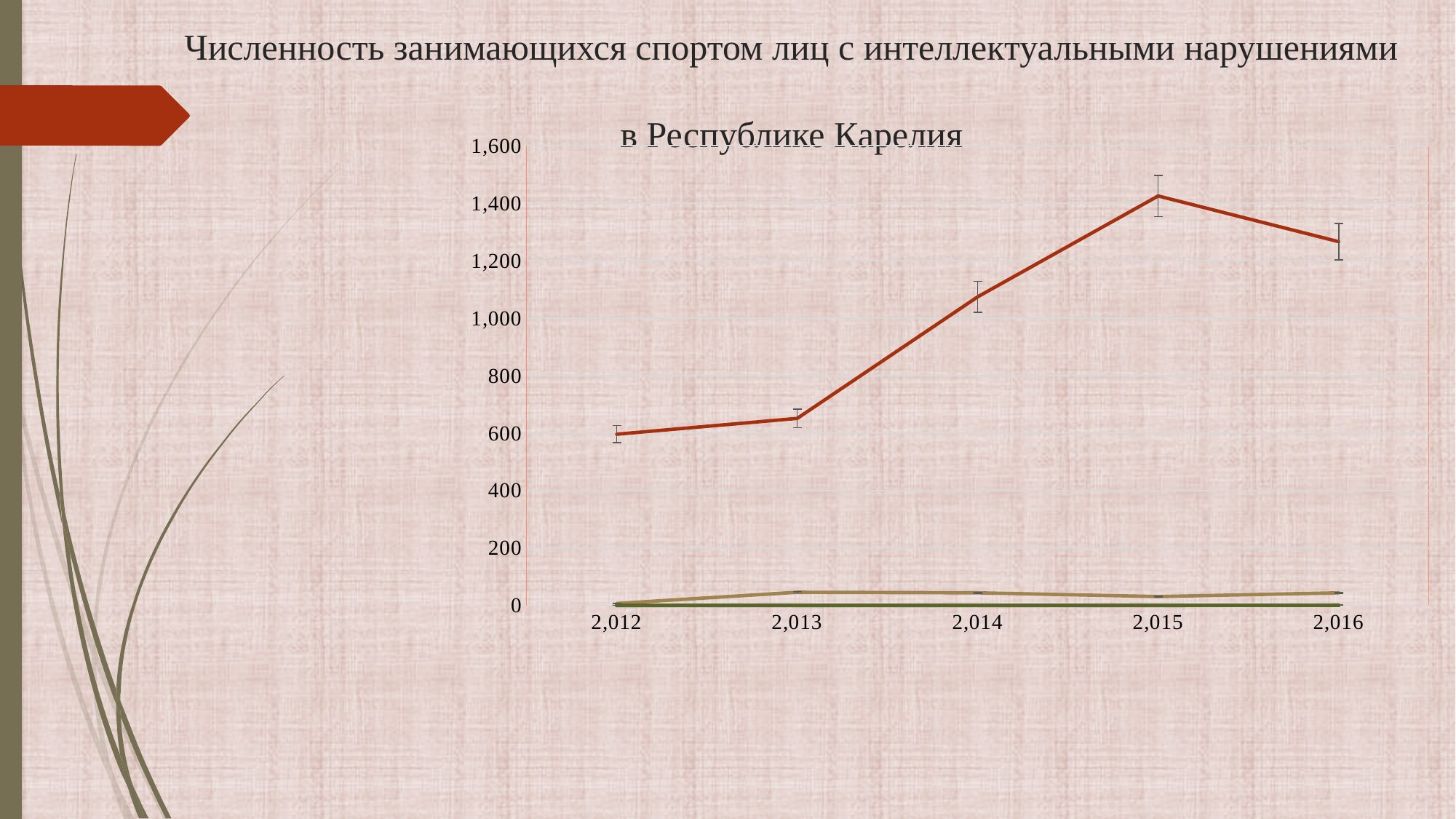
How many years are shown along the x axis of the chart? 5 Is the value of the red line in 2,012 greater or less than 800? less Is the value of the red line in 2,014 greater or less than 1,000? greater In which year does the red line reach its highest point? 2,015 Which is larger for the red line: the value in 2,013 or the value in 2,014? 2,014 Does the red line rise or fall between 2,015 and 2,016? fall Does the red line rise or fall between 2,012 and 2,015? rise Is the value of the red line in 2,015 greater or less than 1,400? greater What is the first year shown on the x axis of the chart? 2,012 What kind of chart is shown on the slide? line chart In which year is the red line at its lowest point? 2,012